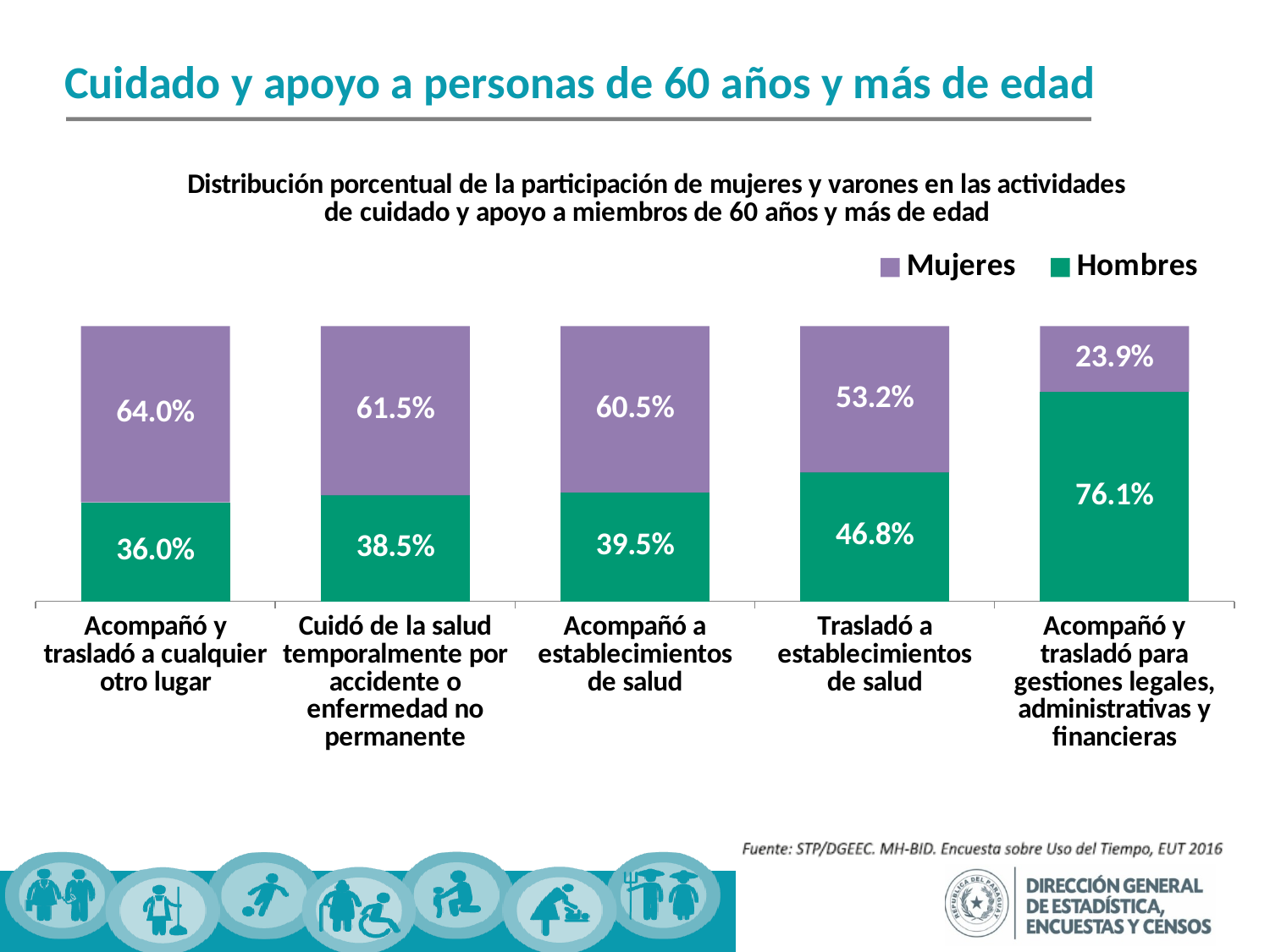
What is the Hombres value for 'Trasladó a establecimientos de salud'? 46.8% Which colour represents Hombres in the chart? Green What kind of chart is shown on the slide? Stacked bar chart How many series does the legend list? 2 What is the difference between the Mujeres and Hombres values for 'Cuidó de la salud temporalmente por accidente o enfermedad no permanente'? 23.0% What is the Mujeres value for 'Acompañó y trasladó a cualquier otro lugar'? 64.0% How many categories are shown on the x axis? 5 What is the Hombres value for 'Acompañó y trasladó para gestiones legales, administrativas y financieras'? 76.1% Which category has the lowest Hombres value? Acompañó y trasladó a cualquier otro lugar Which category has the highest Mujeres value? Acompañó y trasladó a cualquier otro lugar Which is larger for 'Trasladó a establecimientos de salud': the Mujeres value or the Hombres value? Mujeres What is the Mujeres value for 'Acompañó a establecimientos de salud'? 60.5%